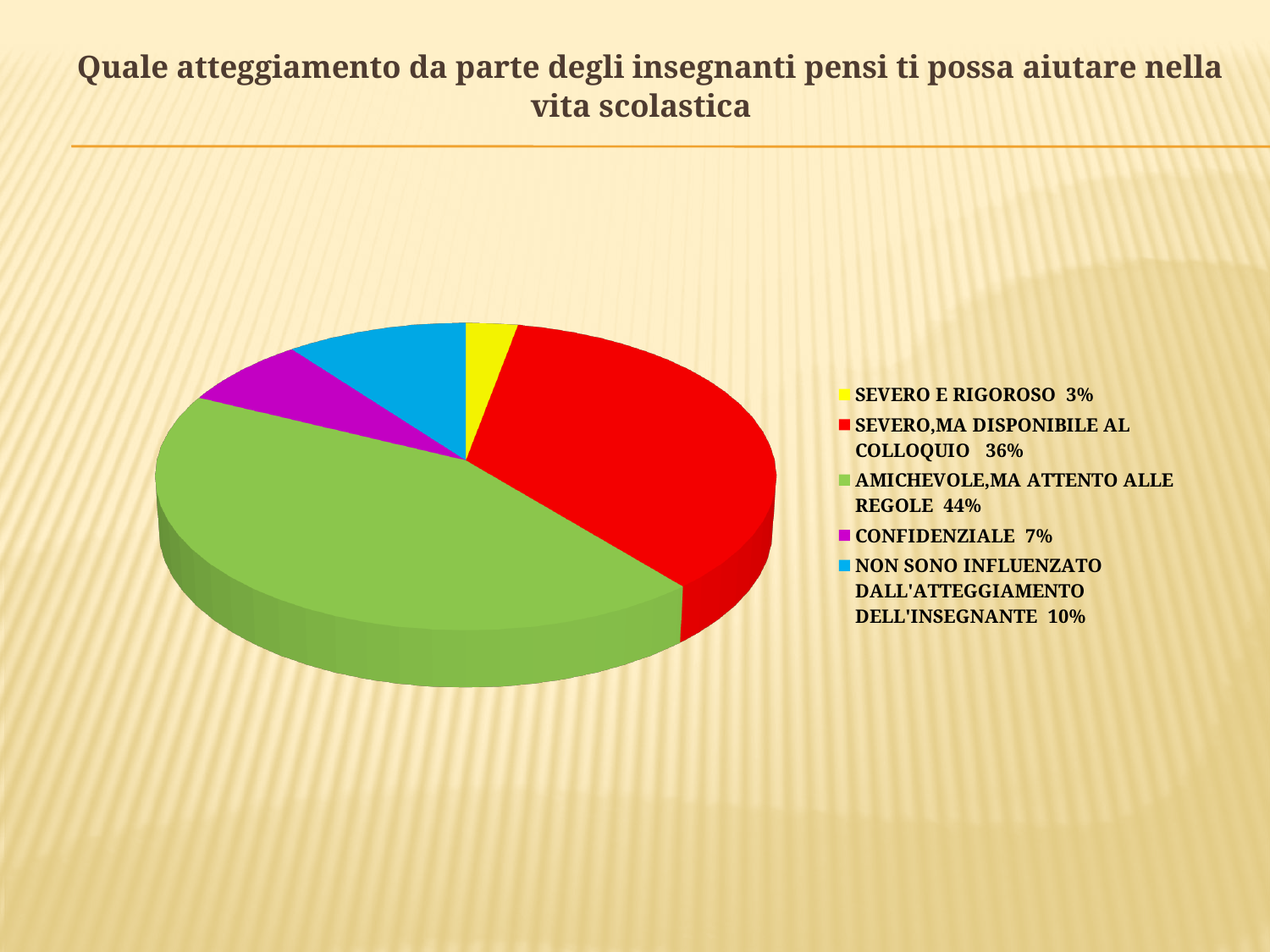
What percentage is shown for CONFIDENZIALE? 7% What is the difference in percentage points between AMICHEVOLE,MA ATTENTO ALLE REGOLE and SEVERO,MA DISPONIBILE AL COLLOQUIO? 8 What percentage is shown for NON SONO INFLUENZATO DALL'ATTEGGIAMENTO DELL'INSEGNANTE? 10% How many categories does the pie chart have? 5 Which category has the largest share of the pie? AMICHEVOLE,MA ATTENTO ALLE REGOLE What colour is the slice for SEVERO,MA DISPONIBILE AL COLLOQUIO? red What percentage is shown for SEVERO E RIGOROSO? 3% What percentage is shown for AMICHEVOLE,MA ATTENTO ALLE REGOLE? 44% What kind of chart is shown on the slide? pie chart Which category has the smallest share of the pie? SEVERO E RIGOROSO Which is larger, the share for CONFIDENZIALE or the share for NON SONO INFLUENZATO DALL'ATTEGGIAMENTO DELL'INSEGNANTE? NON SONO INFLUENZATO DALL'ATTEGGIAMENTO DELL'INSEGNANTE What percentage is shown for SEVERO,MA DISPONIBILE AL COLLOQUIO? 36%